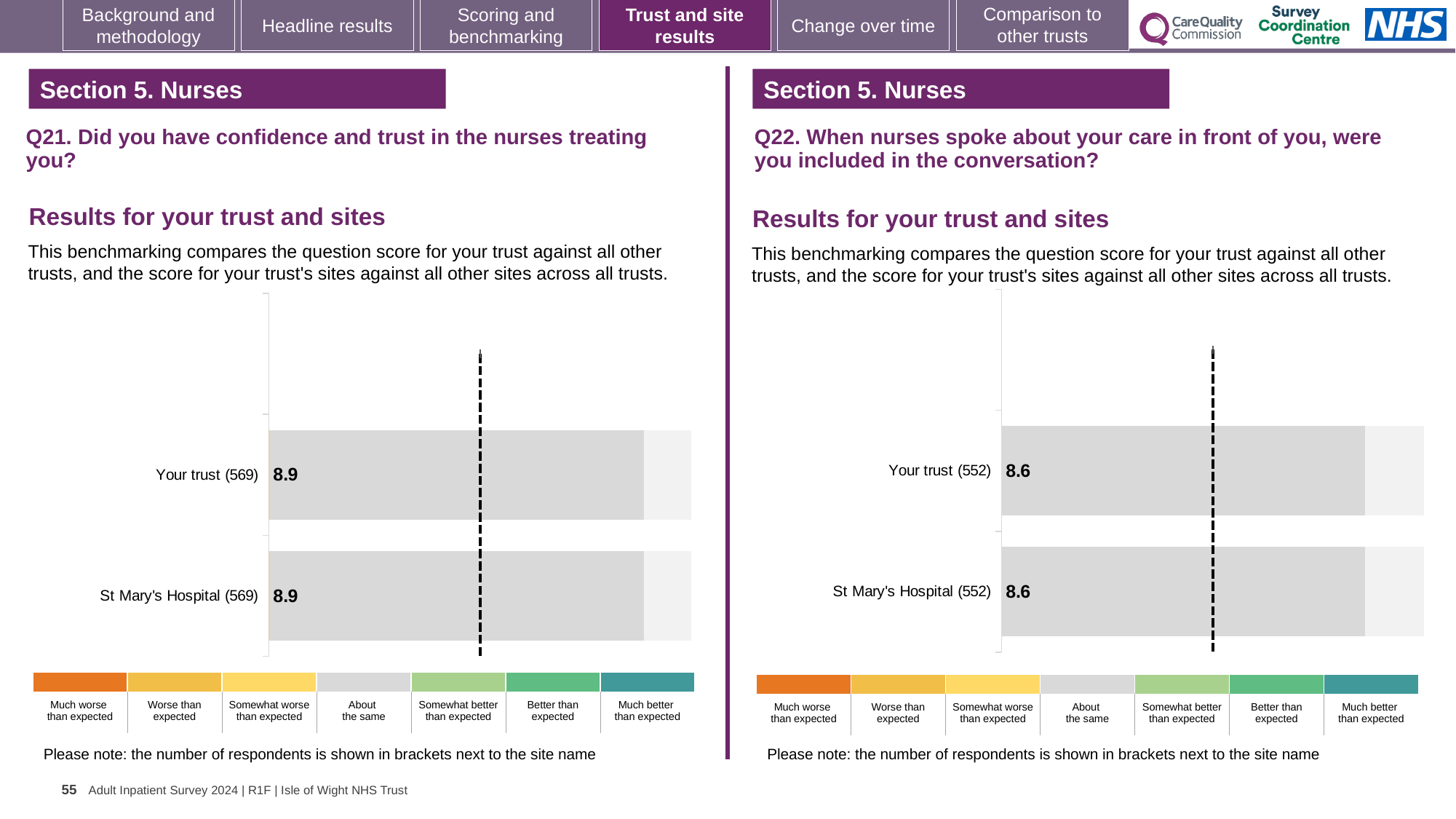
On the Q21 chart on the left, what is the score for Your trust? 8.9 Is the score for Your trust on the Q22 chart on the right greater or less than the score for Your trust on the Q21 chart on the left? less How many bars are plotted on the Q21 chart on the left? 2 On the Q21 chart on the left, what is the difference between the score for Your trust and the score for St Mary's Hospital? 0 On the Q22 chart on the right, what is the difference between the score for Your trust and the score for St Mary's Hospital? 0 On the Q21 chart on the left, how many respondents are shown in brackets next to Your trust? 569 On the Q22 chart on the right, what is the score for Your trust? 8.6 On the Q21 chart on the left, what is the score for St Mary's Hospital? 8.9 What kind of chart is the Q21 chart on the left? Bar chart On the Q22 chart on the right, how many respondents are shown in brackets next to St Mary's Hospital? 552 How many bars are plotted on the Q22 chart on the right? 2 On the Q22 chart on the right, what is the score for St Mary's Hospital? 8.6